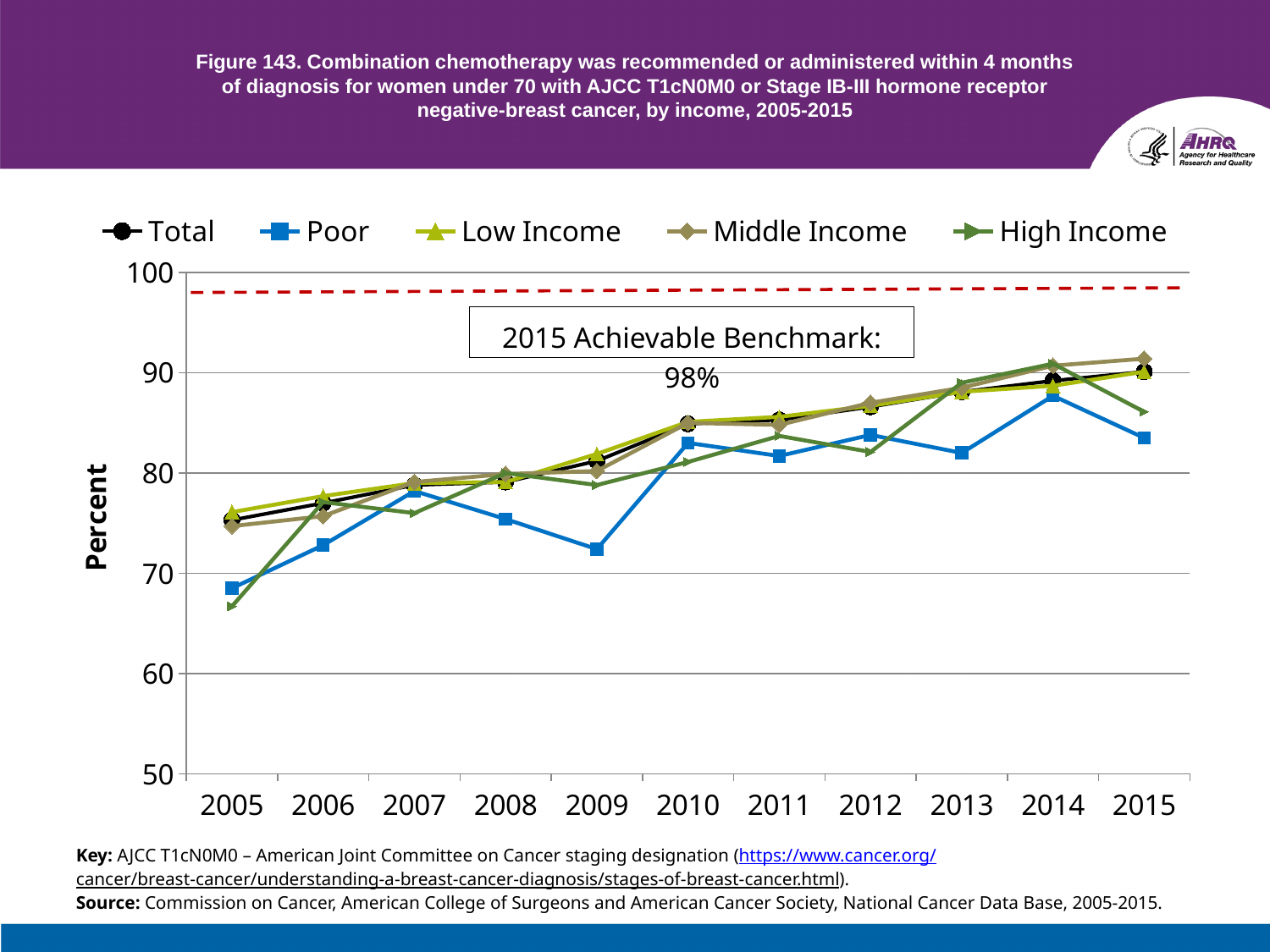
In 2009, which is larger, the value for Poor or the value for Low Income? Low Income What is the 2015 Achievable Benchmark value shown on the chart? 98% Does the Total series generally rise or fall from 2005 to 2015? Rise How many series does the legend list? 5 Is the value for Middle Income in 2015 greater or less than 90? greater Is the value for Poor in 2015 greater or less than 90? less Which series has the lowest value in 2015? Poor Is the value for Poor in 2005 greater or less than 70? less What kind of chart is shown on the slide? Line chart How many years are plotted along the x axis? 11 Which series has the lowest value in 2009? Poor What is the label on the y axis? Percent